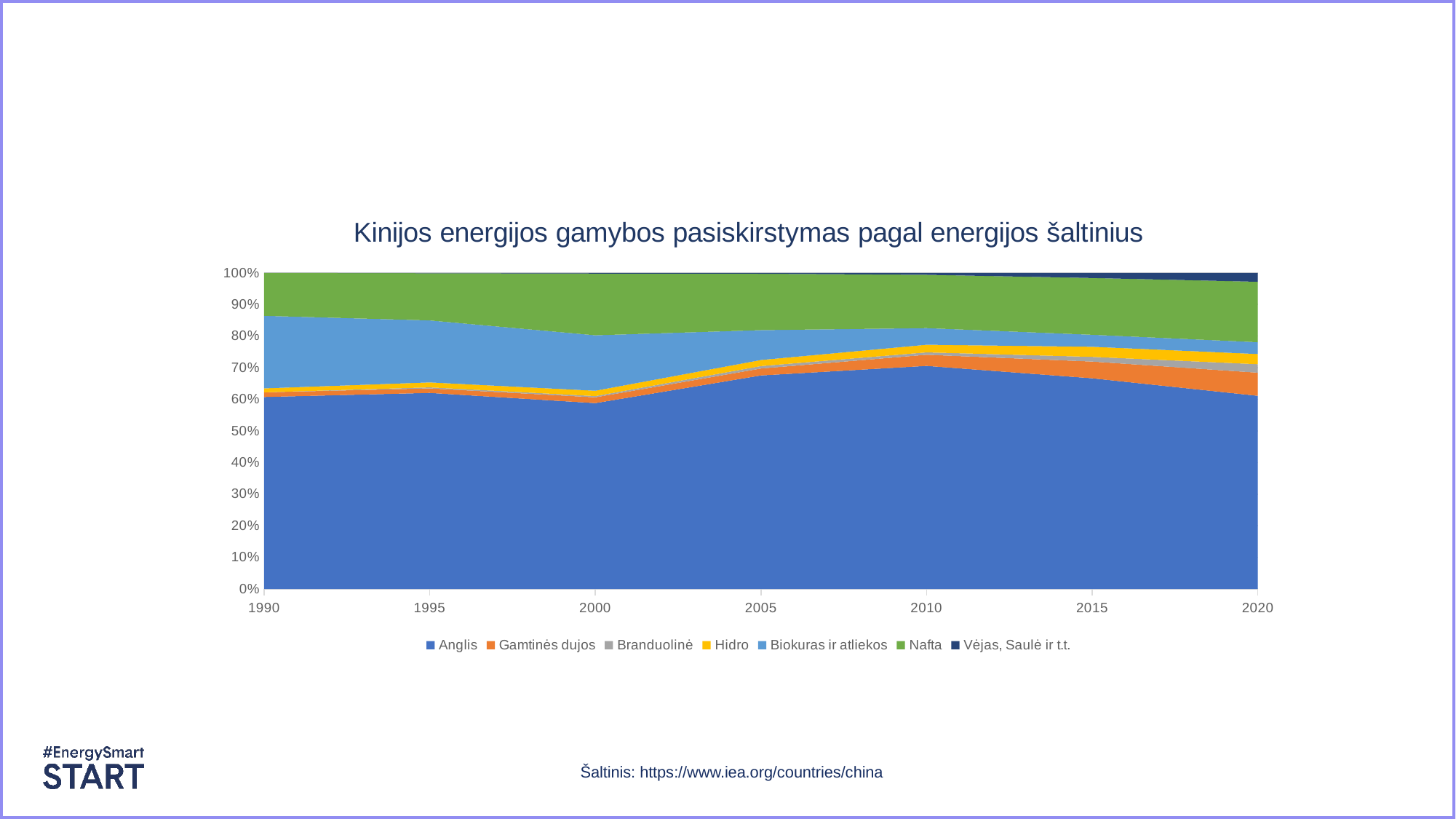
Does the share of Vėjas, Saulė ir t.t. rise or fall between 2010 and 2020? rise Which series is plotted at the bottom of the stack? Anglis Does the share of Anglis rise or fall between 2010 and 2020? fall In 2020, which has the larger share, Anglis or Nafta? Anglis How many years are labelled on the x axis? 7 Is the share of Anglis in 2010 greater or less than 80%? less Is the share of Anglis in 2000 greater or less than 70%? less What kind of chart is shown on the slide? Stacked area chart How many series does the legend list? 7 Is the share of Anglis in 2010 greater or less than 60%? greater What is the title of the chart? Kinijos energijos gamybos pasiskirstymas pagal energijos šaltinius